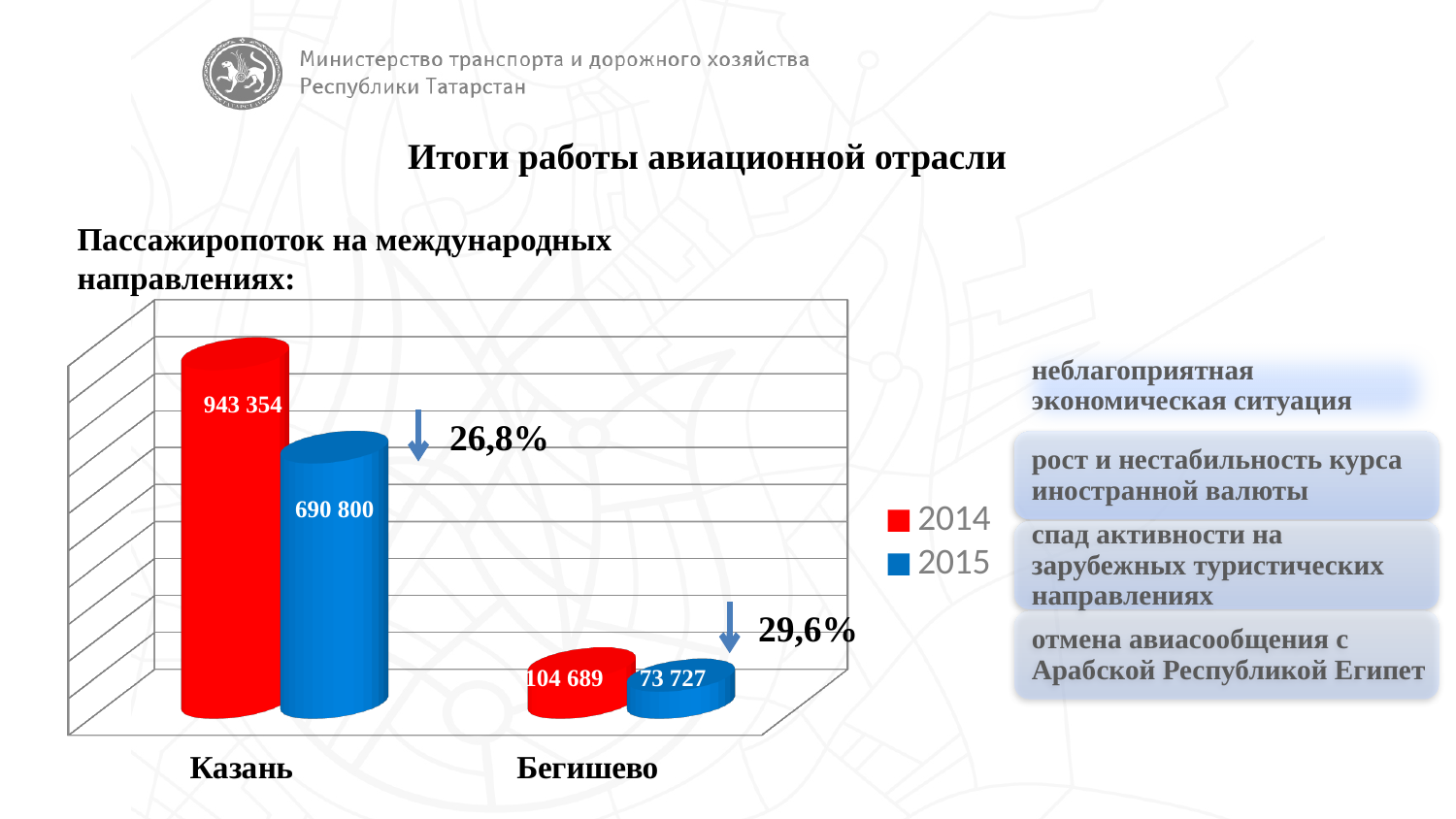
How many series does the legend list? 2 How many airports (categories) are shown on the chart? 2 By how much did the international passenger flow for Казань decrease from 2014 to 2015? 252 554 What was the international passenger flow for Бегишево in 2015? 73 727 What was the international passenger flow for Казань in 2015? 690 800 Which airport had the highest international passenger flow in 2014? Казань What was the international passenger flow for Казань in 2014? 943 354 What type of chart is used to show the international passenger flow? Bar chart What was the international passenger flow for Бегишево in 2014? 104 689 Which airport had the lowest international passenger flow in 2015? Бегишево Which is larger: the 2015 value for Казань or the 2014 value for Бегишево? 2015 value for Казань By how much did the international passenger flow for Бегишево decrease from 2014 to 2015? 30 962